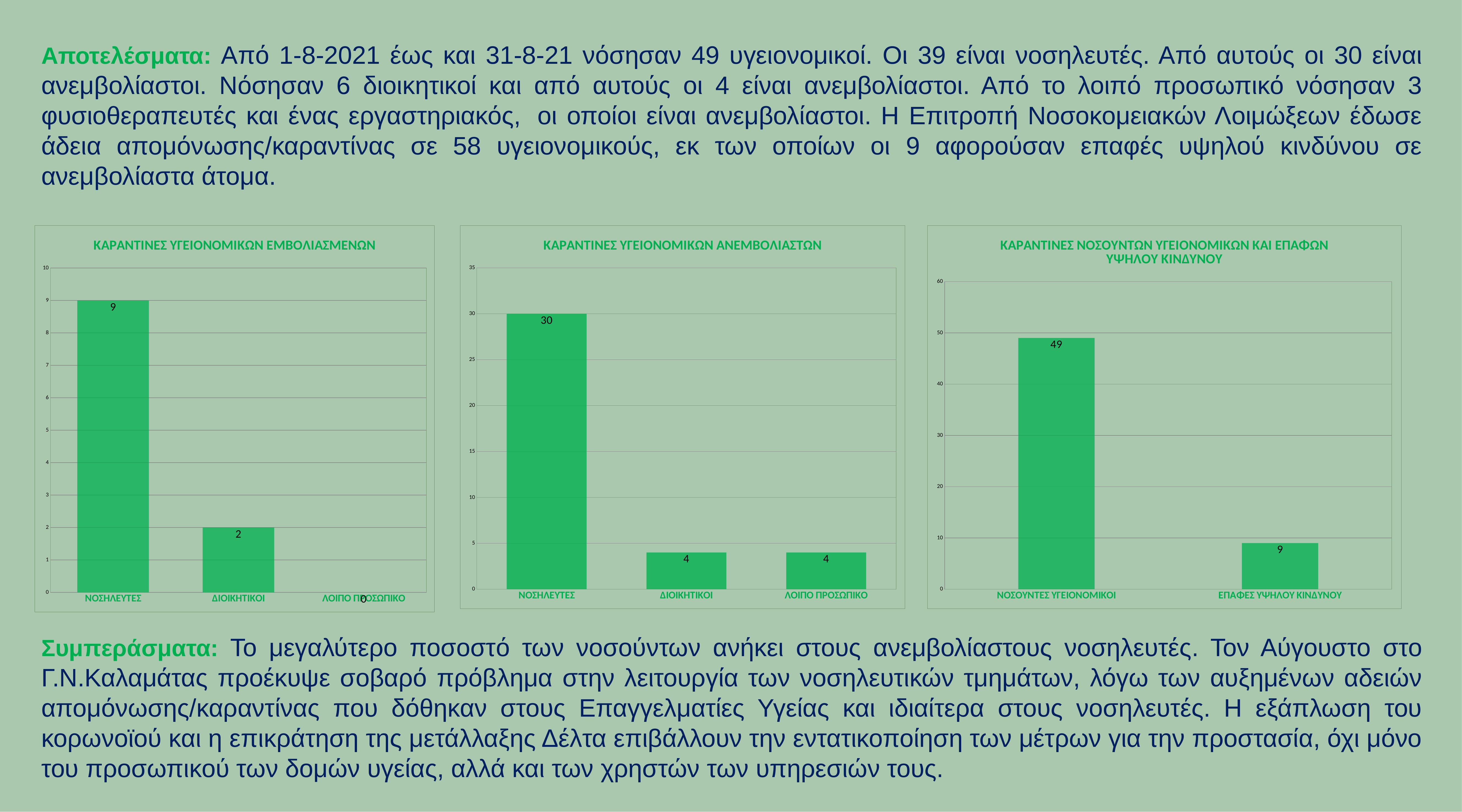
In the middle chart (ΚΑΡΑΝΤΙΝΕΣ ΥΓΕΙΟΝΟΜΙΚΩΝ ΑΝΕΜΒΟΛΙΑΣΤΩΝ), what is the value for ΝΟΣΗΛΕΥΤΕΣ? 30 In the left chart (ΚΑΡΑΝΤΙΝΕΣ ΥΓΕΙΟΝΟΜΙΚΩΝ ΕΜΒΟΛΙΑΣΜΕΝΩΝ), what is the value for ΔΙΟΙΚΗΤΙΚΟΙ? 2 In the middle chart (ΚΑΡΑΝΤΙΝΕΣ ΥΓΕΙΟΝΟΜΙΚΩΝ ΑΝΕΜΒΟΛΙΑΣΤΩΝ), what is the value for ΛΟΙΠΟ ΠΡΟΣΩΠΙΚΟ? 4 In the middle chart (ΚΑΡΑΝΤΙΝΕΣ ΥΓΕΙΟΝΟΜΙΚΩΝ ΑΝΕΜΒΟΛΙΑΣΤΩΝ), which category has the highest value? ΝΟΣΗΛΕΥΤΕΣ In the left chart (ΚΑΡΑΝΤΙΝΕΣ ΥΓΕΙΟΝΟΜΙΚΩΝ ΕΜΒΟΛΙΑΣΜΕΝΩΝ), what is the value for ΝΟΣΗΛΕΥΤΕΣ? 9 In the right chart (ΚΑΡΑΝΤΙΝΕΣ ΝΟΣΟΥΝΤΩΝ ΥΓΕΙΟΝΟΜΙΚΩΝ ΚΑΙ ΕΠΑΦΩΝ ΥΨΗΛΟΥ ΚΙΝΔΥΝΟΥ), how many categories are shown? 2 In the left chart (ΚΑΡΑΝΤΙΝΕΣ ΥΓΕΙΟΝΟΜΙΚΩΝ ΕΜΒΟΛΙΑΣΜΕΝΩΝ), which is larger, ΝΟΣΗΛΕΥΤΕΣ or ΔΙΟΙΚΗΤΙΚΟΙ? ΝΟΣΗΛΕΥΤΕΣ In the right chart (ΚΑΡΑΝΤΙΝΕΣ ΝΟΣΟΥΝΤΩΝ ΥΓΕΙΟΝΟΜΙΚΩΝ ΚΑΙ ΕΠΑΦΩΝ ΥΨΗΛΟΥ ΚΙΝΔΥΝΟΥ), what is the value for ΝΟΣΟΥΝΤΕΣ ΥΓΕΙΟΝΟΜΙΚΟΙ? 49 In the right chart (ΚΑΡΑΝΤΙΝΕΣ ΝΟΣΟΥΝΤΩΝ ΥΓΕΙΟΝΟΜΙΚΩΝ ΚΑΙ ΕΠΑΦΩΝ ΥΨΗΛΟΥ ΚΙΝΔΥΝΟΥ), what is the value for ΕΠΑΦΕΣ ΥΨΗΛΟΥ ΚΙΝΔΥΝΟΥ? 9 In the left chart (ΚΑΡΑΝΤΙΝΕΣ ΥΓΕΙΟΝΟΜΙΚΩΝ ΕΜΒΟΛΙΑΣΜΕΝΩΝ), which category has the lowest value? ΛΟΙΠΟ ΠΡΟΣΩΠΙΚΟ What kind of chart is the middle chart (ΚΑΡΑΝΤΙΝΕΣ ΥΓΕΙΟΝΟΜΙΚΩΝ ΑΝΕΜΒΟΛΙΑΣΤΩΝ)? Bar chart In the middle chart (ΚΑΡΑΝΤΙΝΕΣ ΥΓΕΙΟΝΟΜΙΚΩΝ ΑΝΕΜΒΟΛΙΑΣΤΩΝ), what is the difference between ΝΟΣΗΛΕΥΤΕΣ and ΔΙΟΙΚΗΤΙΚΟΙ? 26